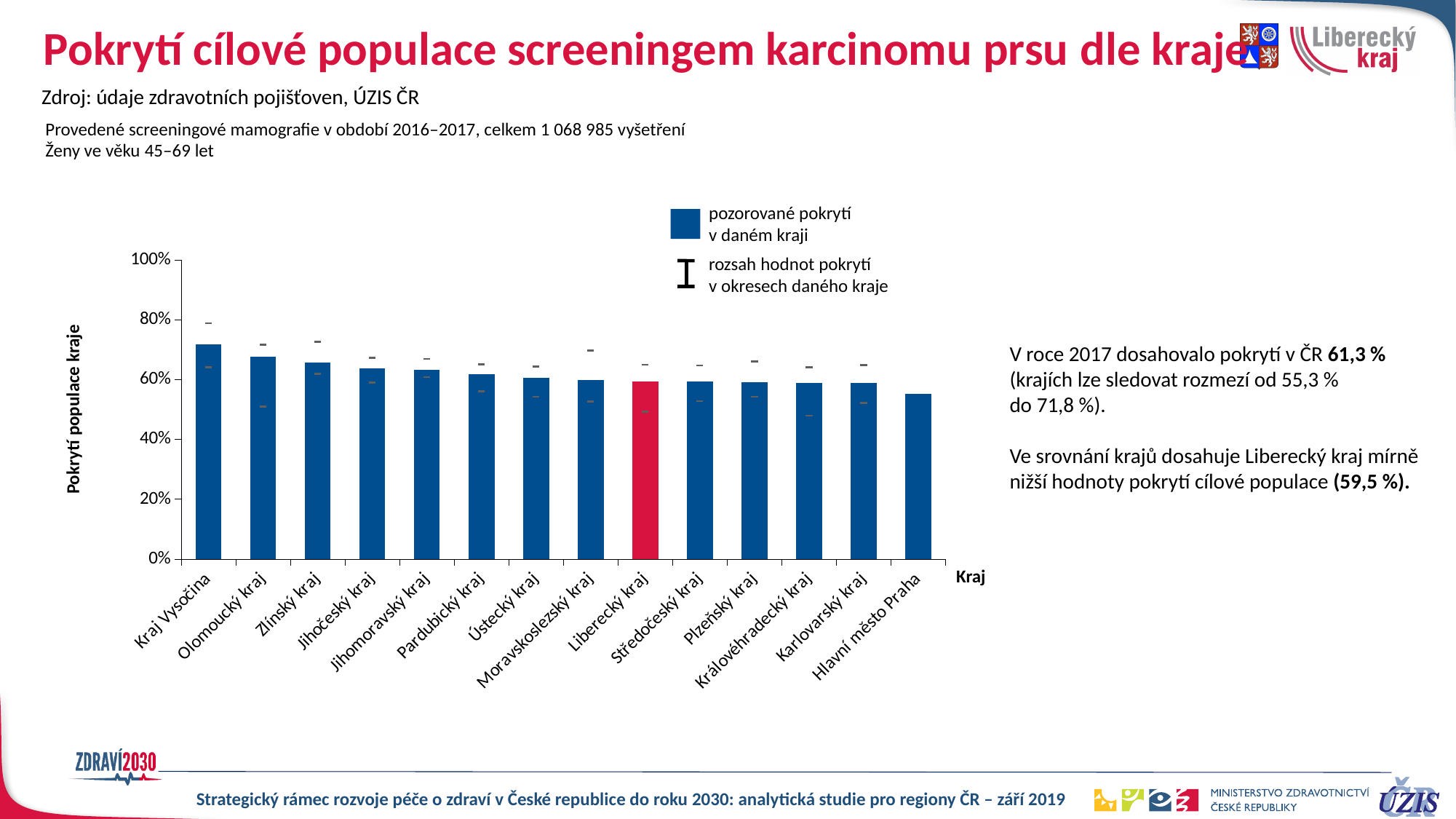
Is the value for Olomoucký kraj greater or less than 80%? less Which region's bar is highlighted in red in the chart? Liberecký kraj Which region has the lowest observed coverage in the chart? Hlavní město Praha Is the value for Kraj Vysočina greater or less than 60%? greater How many entries does the chart legend list? 2 What kind of chart is shown on the slide? bar chart How many regions (kraje) are shown on the x axis of the chart? 14 Which has the larger value, Kraj Vysočina or Hlavní město Praha? Kraj Vysočina What is the coverage value for Liberecký kraj stated on the slide? 59,5 % Do the bar values rise or fall from left to right along the x axis? fall Which region has the highest observed coverage in the chart? Kraj Vysočina Is the value for Hlavní město Praha greater or less than 60%? less